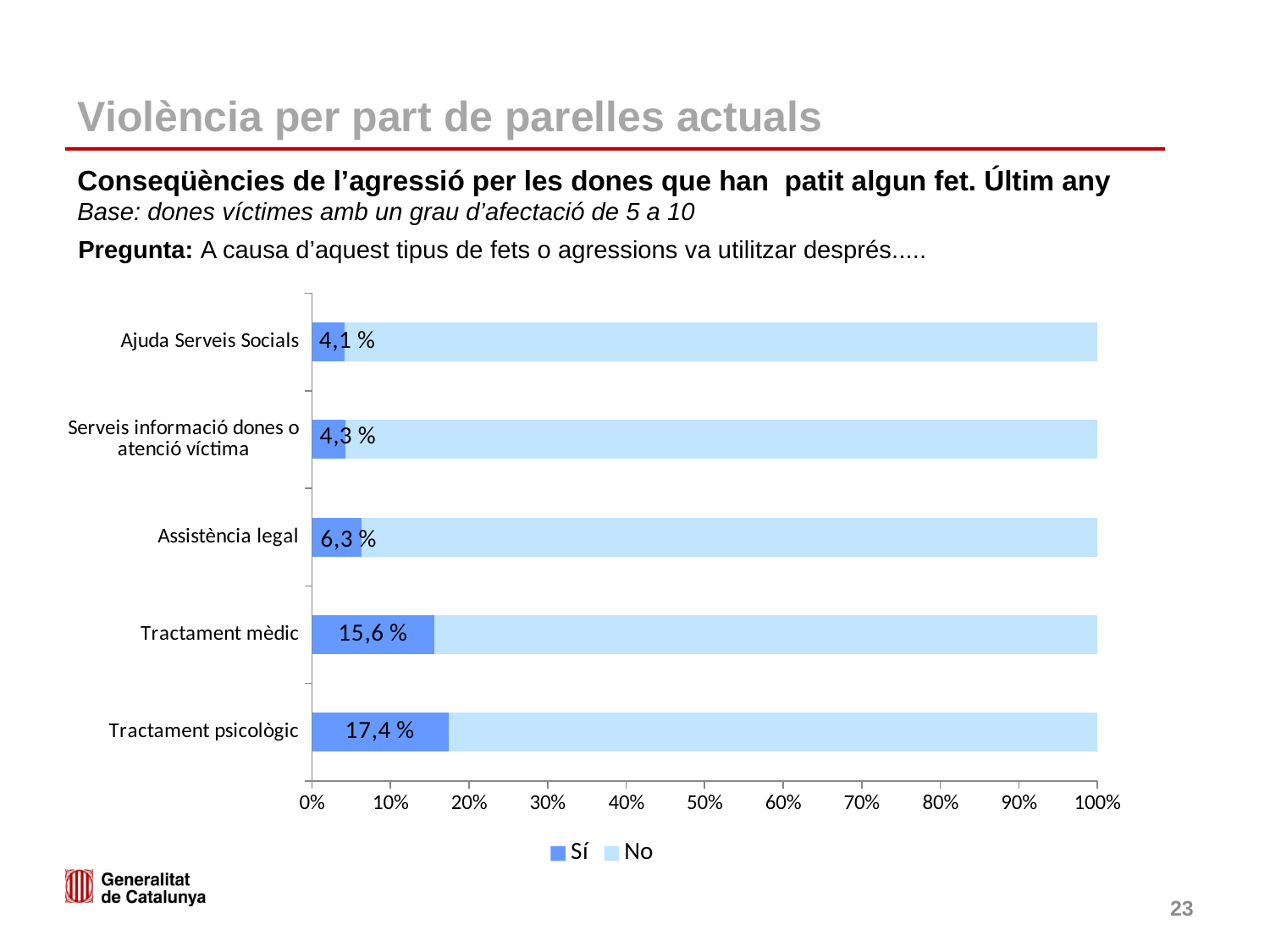
What is the 'Sí' value for Tractament psicològic? 17,4 % What kind of chart is shown on the slide? Stacked bar chart How many series does the legend list? 2 What is the 'Sí' value for Tractament mèdic? 15,6 % Which category has the highest 'Sí' value? Tractament psicològic Which has a larger 'Sí' value: Assistència legal or Serveis informació dones o atenció víctima? Assistència legal What is the difference between the 'Sí' values for Tractament psicològic and Tractament mèdic? 1,8 % Which category has the lowest 'Sí' value? Ajuda Serveis Socials What is the 'Sí' value for Ajuda Serveis Socials? 4,1 % Is the 'No' value for Tractament psicològic greater or less than 80%? greater What is the 'Sí' value for Assistència legal? 6,3 % How many categories are shown in the chart? 5